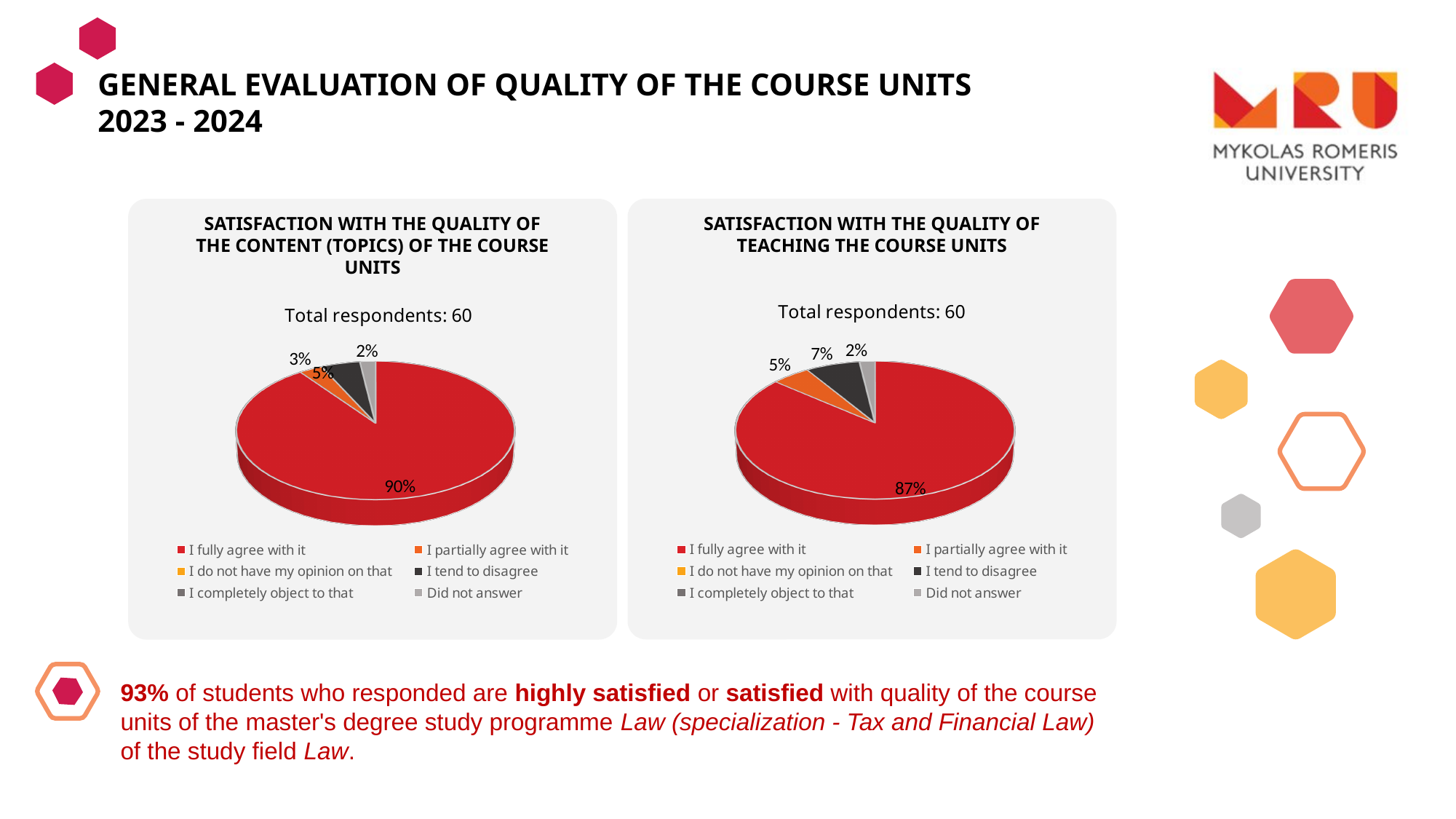
Which response has the largest share in the chart titled 'Satisfaction with the quality of the content (topics) of the course units'? I fully agree with it In the chart titled 'Satisfaction with the quality of teaching the course units', what percentage of respondents did not answer? 2% Which response has the largest share in the chart titled 'Satisfaction with the quality of teaching the course units'? I fully agree with it In the chart titled 'Satisfaction with the quality of teaching the course units', what percentage of respondents chose 'I tend to disagree'? 7% In the chart titled 'Satisfaction with the quality of teaching the course units', which is larger: the share for 'I tend to disagree' or the share for 'I partially agree with it'? I tend to disagree How many entries does the legend list in the chart titled 'Satisfaction with the quality of the content (topics) of the course units'? 6 In the chart titled 'Satisfaction with the quality of the content (topics) of the course units', what percentage of respondents chose 'I fully agree with it'? 90% In the chart titled 'Satisfaction with the quality of teaching the course units', what percentage of respondents chose 'I partially agree with it'? 5% What is the difference between the 'I fully agree with it' share in the left chart (content) and in the right chart (teaching)? 3% What type of chart is used in the chart titled 'Satisfaction with the quality of teaching the course units'? Pie chart In the chart titled 'Satisfaction with the quality of teaching the course units', what percentage of respondents chose 'I fully agree with it'? 87% In the chart titled 'Satisfaction with the quality of the content (topics) of the course units', what percentage of respondents did not answer? 2%